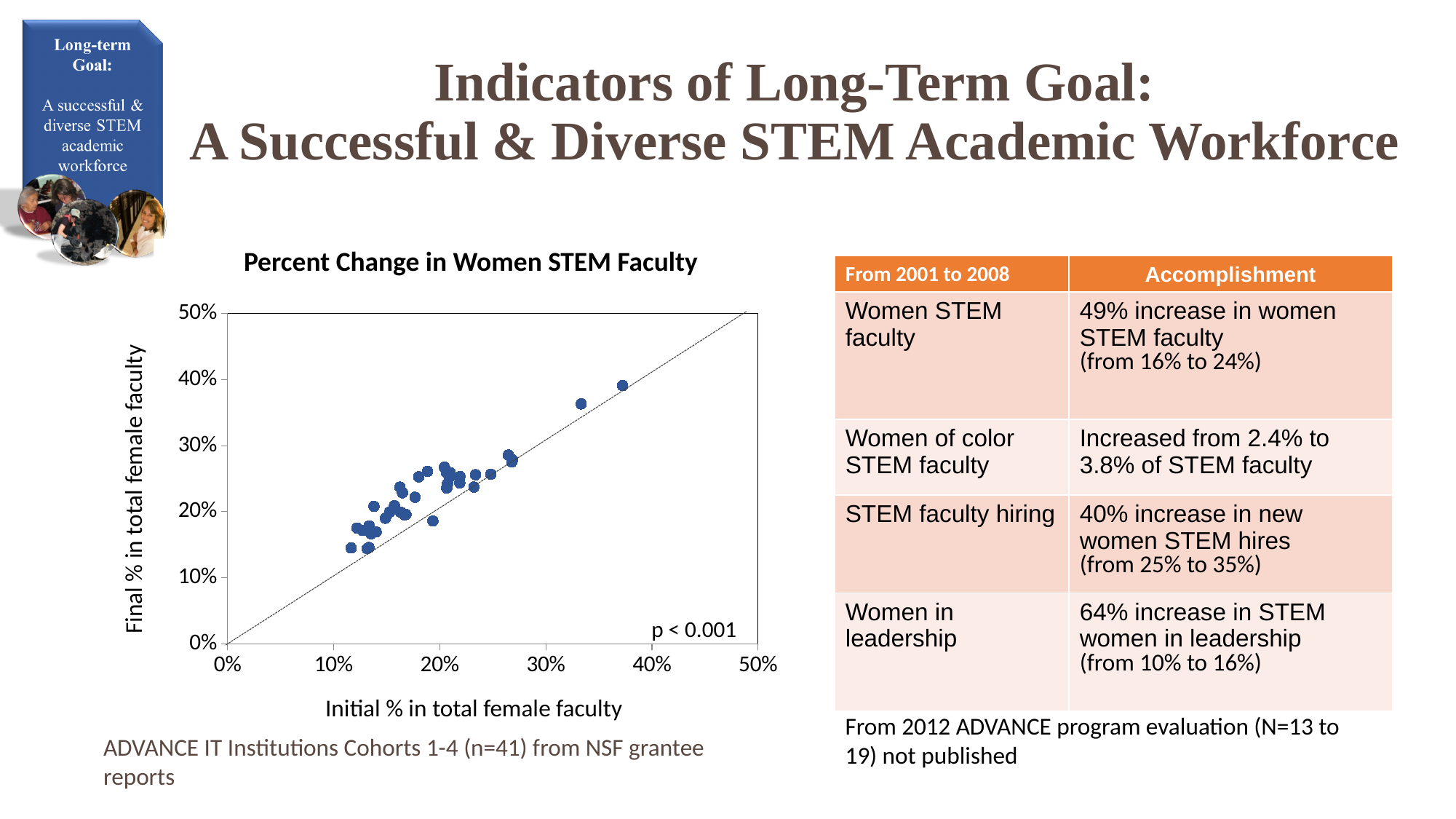
According to the caption below the chart, how many institutions (n) are plotted? 41 What kind of chart is shown on the slide? scatter chart What is the label of the x axis of the chart? Initial % in total female faculty As the initial % in total female faculty increases along the x axis, do the final % values generally rise or fall? rise What p-value is annotated on the chart? p < 0.001 Do most of the plotted points lie above or below the diagonal reference line? above What is the title of the chart? Percent Change in Women STEM Faculty Is the highest final % in total female faculty plotted on the chart greater or less than 30%? greater Is the lowest final % in total female faculty plotted on the chart greater or less than 10%? greater Is the lowest initial % in total female faculty plotted on the chart greater or less than 20%? less